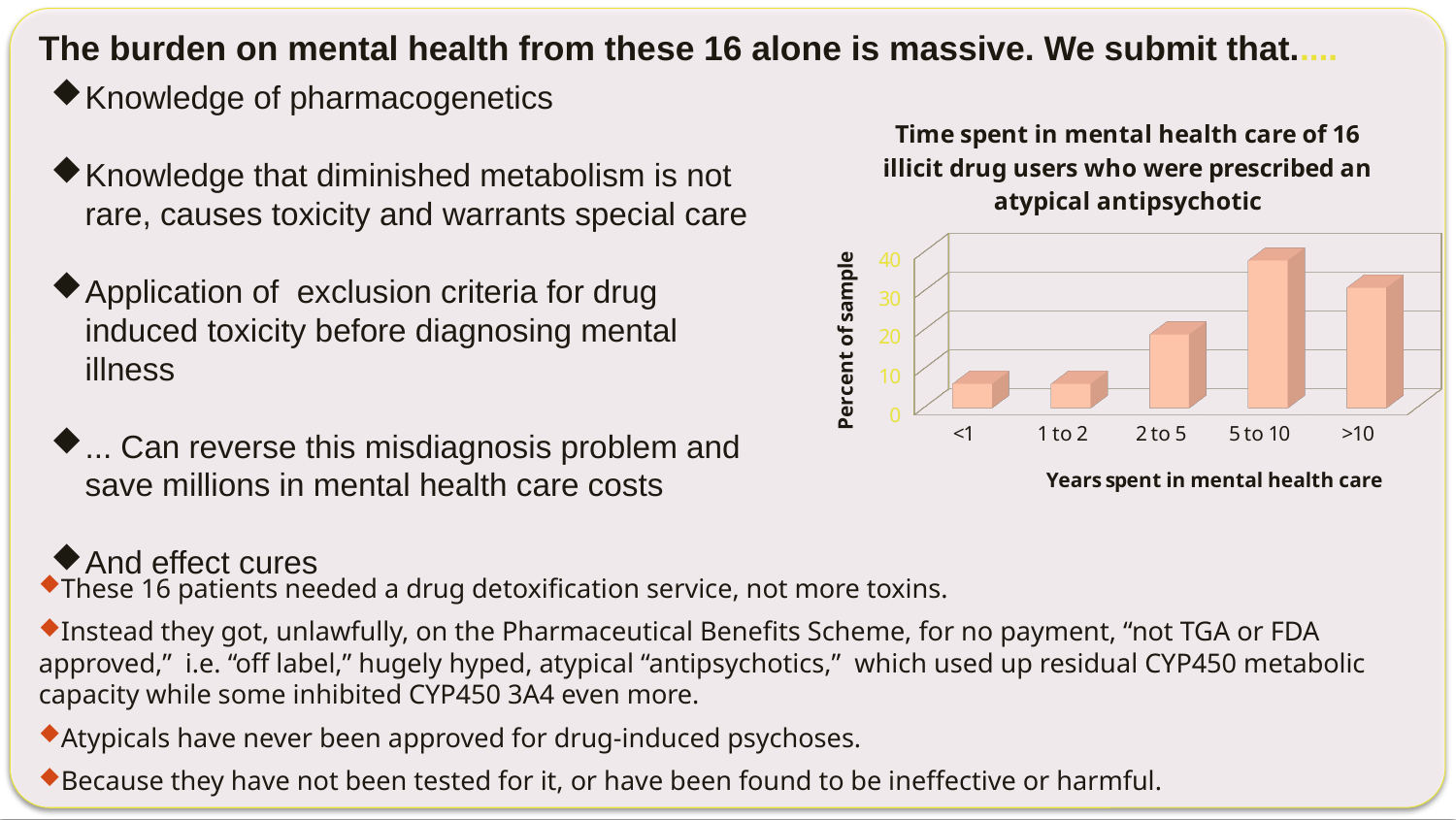
How many categories are shown on the x axis of the chart? 5 Which is larger, the value for 2 to 5 or the value for >10? >10 Is the value for >10 greater or less than 20? greater Is the value for 1 to 2 greater or less than 20? less Is the value for <1 greater or less than 10? less Do the values rise or fall from <1 to 5 to 10 along the x axis? rise Which category has the highest percent of sample? 5 to 10 What is the title of the chart's x axis? Years spent in mental health care Which is larger, the value for 5 to 10 or the value for >10? 5 to 10 What kind of chart is shown on the slide? bar chart